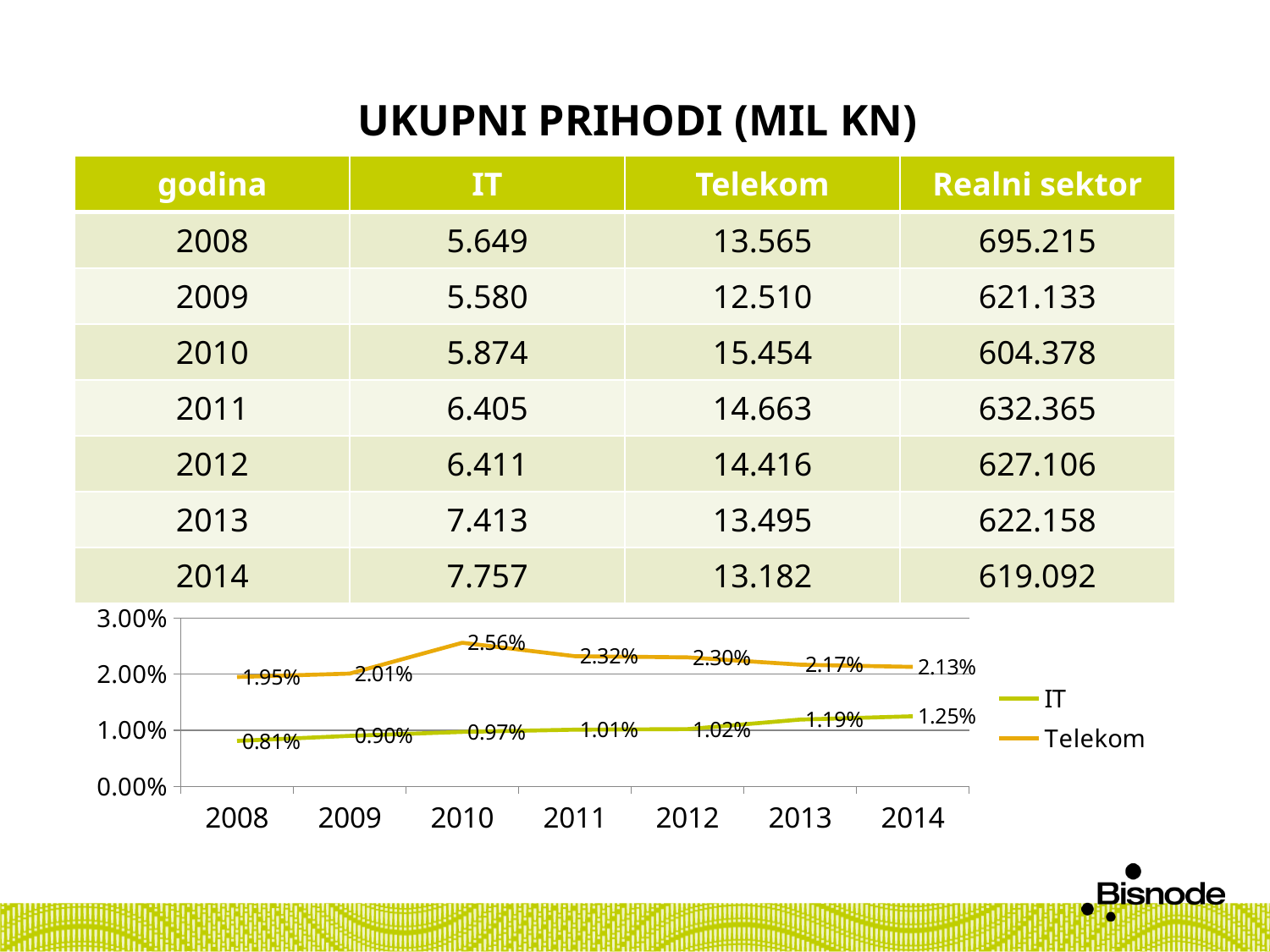
Which series has the higher value in 2013 on the line chart, IT or Telekom? Telekom What is the value for IT in 2008 on the line chart? 0.81% Does the IT series rise or fall from 2008 to 2014 on the line chart? rise What is the difference between the Telekom and IT values in 2012 on the line chart? 1.28% How many series does the legend of the line chart list? 2 In which year does the Telekom series reach its highest value on the line chart? 2010 In which year does the IT series have its lowest value on the line chart? 2008 How many years are plotted on the x axis of the line chart? 7 What kind of chart is shown below the table? line chart What is the value for Telekom in 2010 on the line chart? 2.56% What is the value for IT in 2014 on the line chart? 1.25% Is the value for Telekom in 2011 greater or less than 2.00%? greater